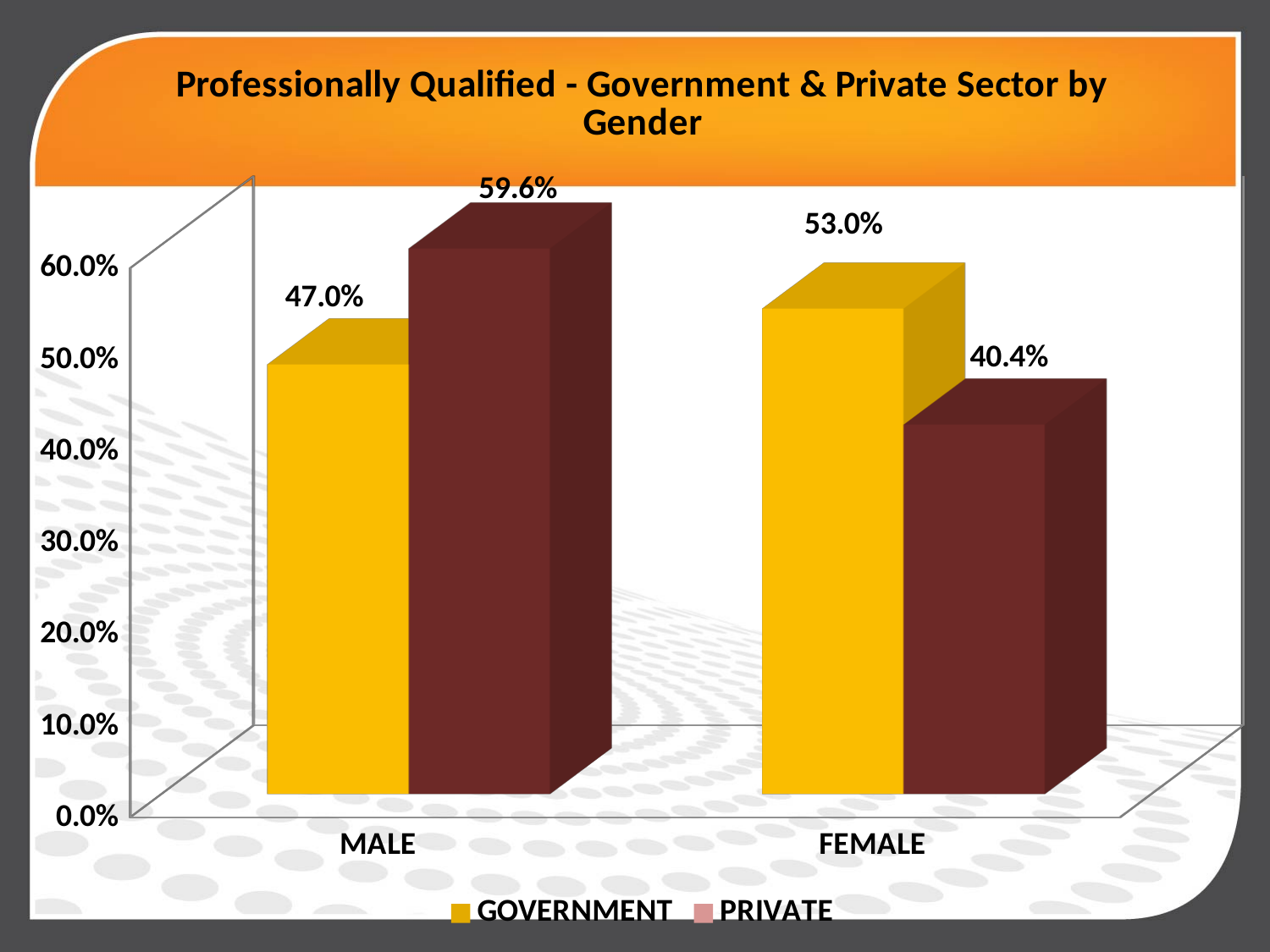
What is the Private value for Female? 40.4% What kind of chart is shown on the slide? bar chart How many categories are shown on the x axis? 2 What is the Government value for Male? 47.0% Is the Government value for Female larger or smaller than the Private value for Female? larger What is the Government value for Female? 53.0% What is the difference between the Government and Private values for Female? 12.6% How many series does the legend list? 2 What is the difference between the Private and Government values for Male? 12.6% Which gender has the higher Private value? Male Which gender has the lower Government value? Male What is the Private value for Male? 59.6%